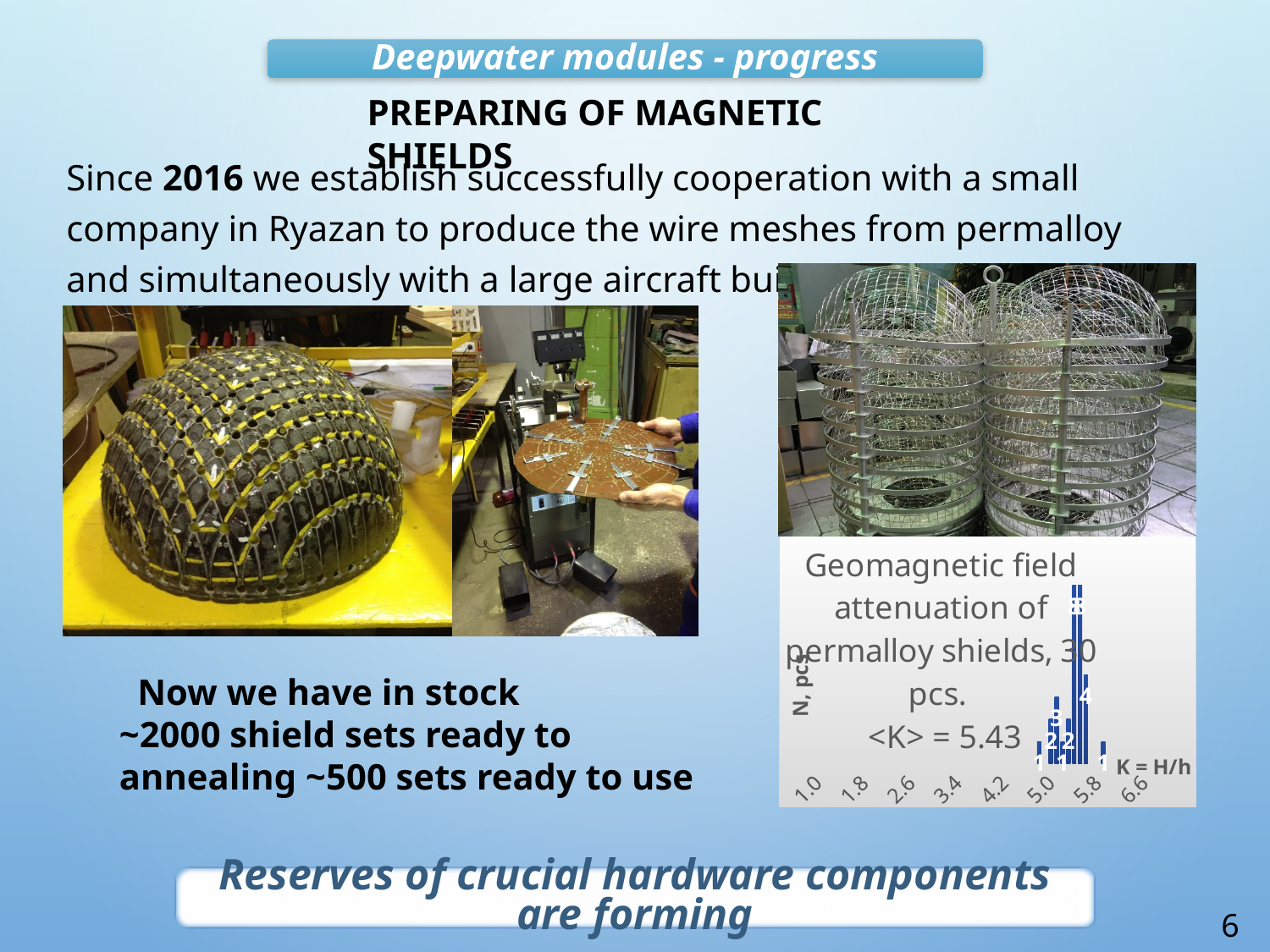
What is the title of the chart on the slide? Geomagnetic field attenuation of permalloy shields, 30 pcs. <K> = 5.43 What is the highest data label shown on any bar in the chart? 8 According to the chart title, what is the mean attenuation <K>? 5.43 What is the first tick label on the horizontal axis of the chart? 1.0 According to the chart title, how many permalloy shields were measured? 30 Is the tallest bar in the chart located above 5.0 or below 5.0 on the horizontal axis? above 5.0 What is the last tick label on the horizontal axis of the chart? 6.6 What is the label of the vertical axis of the chart? N, pcs What kind of chart is shown on the slide? bar chart How many tick labels are shown along the horizontal axis of the chart? 8